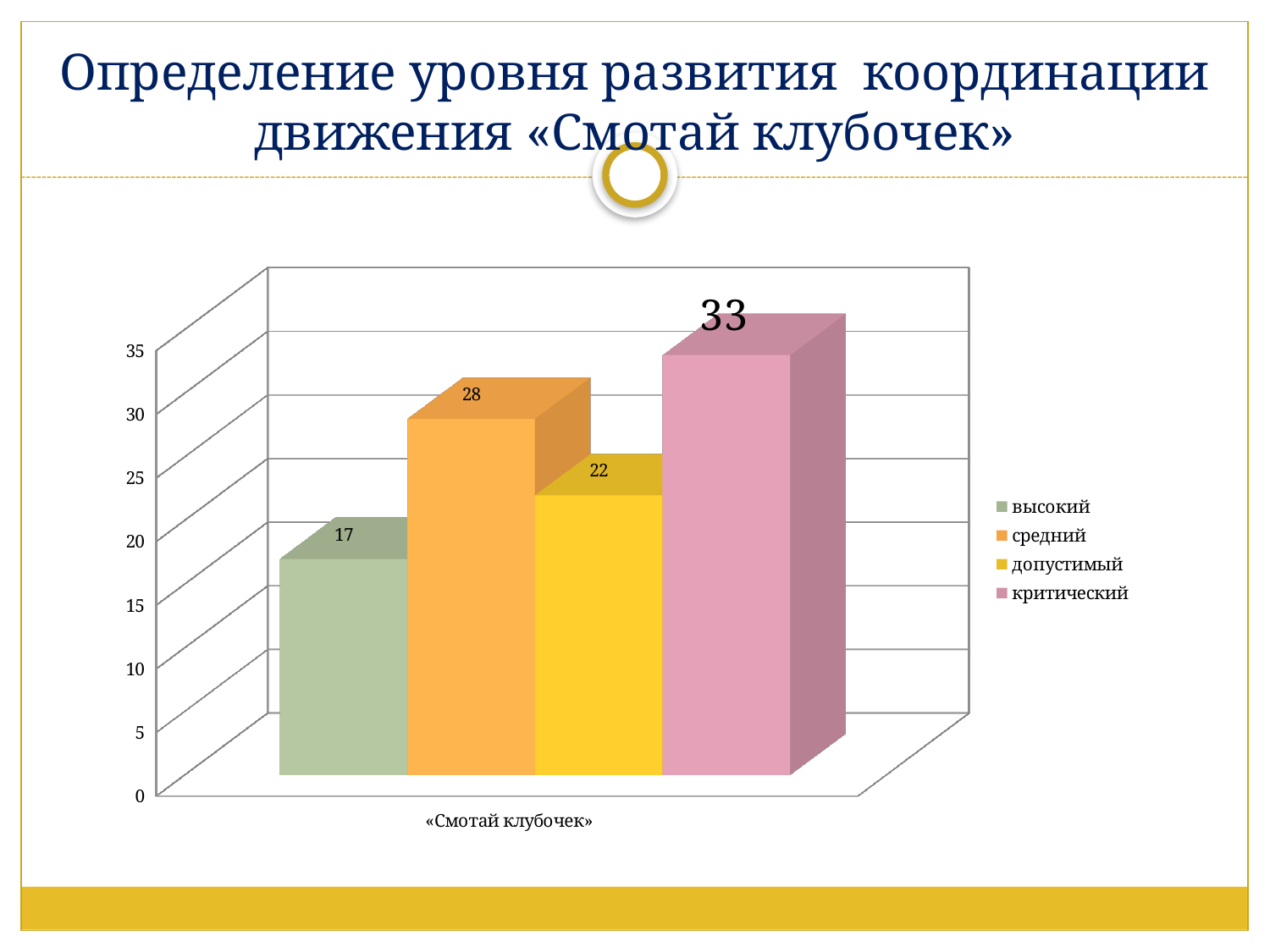
What kind of chart is shown on the slide? bar chart What is the value for высокий? 17 What is the category label shown on the x axis? «Смотай клубочек» Which is larger, the value for средний or the value for допустимый? средний What is the value for средний? 28 What is the difference between the values for средний and допустимый? 6 What is the value for критический? 33 Which series has the lowest value? высокий Which series has the highest value? критический What is the value for допустимый? 22 How many series does the legend list? 4 What is the difference between the values for критический and высокий? 16